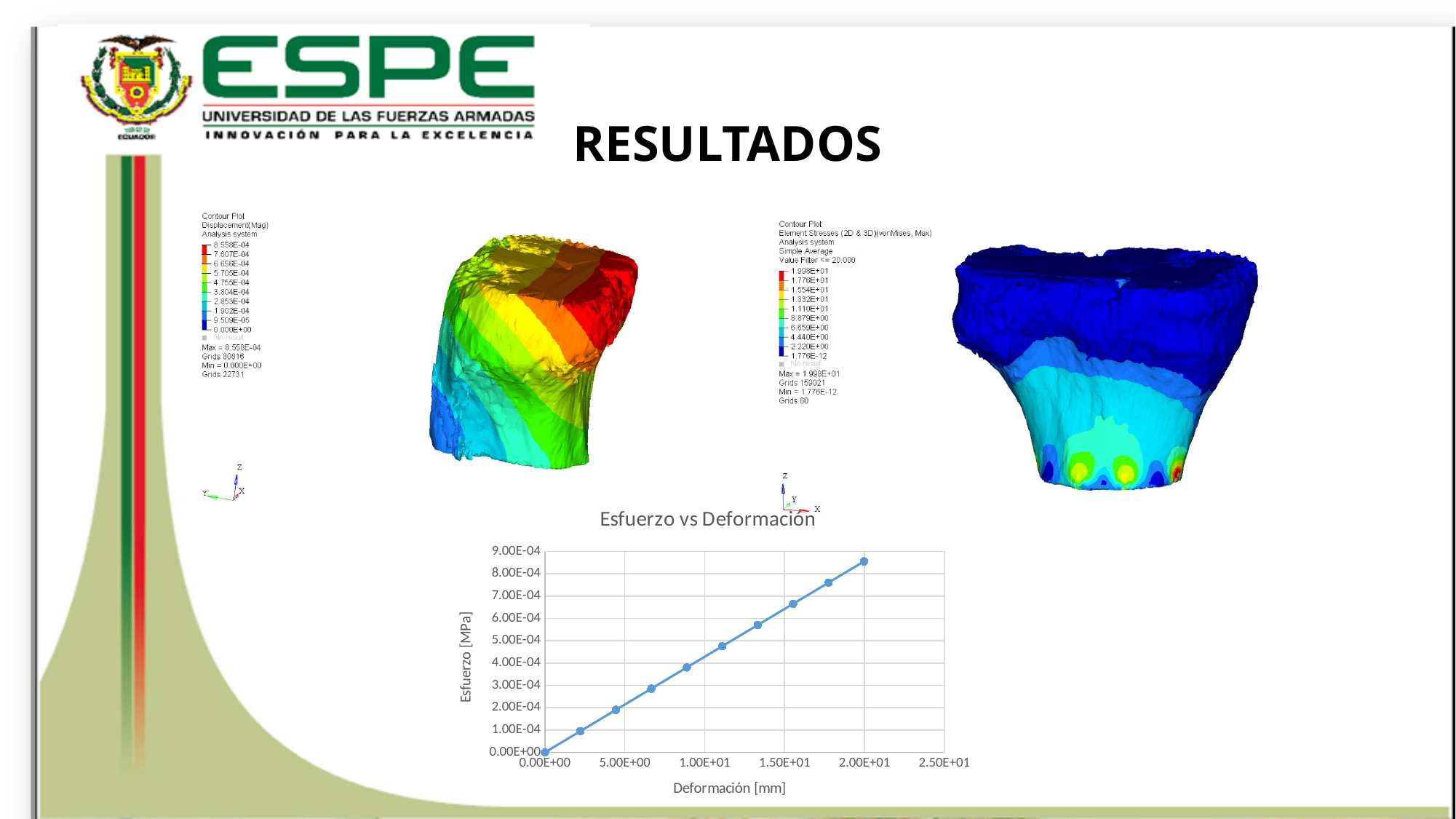
What is the label of the x axis in the 'Esfuerzo vs Deformación' chart? Deformación [mm] How many data points are plotted in the 'Esfuerzo vs Deformación' chart? 10 In the 'Esfuerzo vs Deformación' chart, which point has the highest Esfuerzo value, the one at the largest Deformación or the one at the smallest Deformación? the one at the largest Deformación What kind of chart is 'Esfuerzo vs Deformación'? line chart What is the label of the y axis in the 'Esfuerzo vs Deformación' chart? Esfuerzo [MPa] In the 'Esfuerzo vs Deformación' chart, is the highest plotted Esfuerzo value greater or less than 8.00E-04? greater In the 'Esfuerzo vs Deformación' chart, do the values rise or fall as Deformación increases? rise In the 'Esfuerzo vs Deformación' chart, is the Esfuerzo value at the point near Deformación 1.50E+01 greater or less than 5.00E-04? greater In the 'Esfuerzo vs Deformación' chart, is the Esfuerzo value at the point near Deformación 1.00E+01 greater or less than 5.00E-04? less In the 'Esfuerzo vs Deformación' chart, what is the Esfuerzo value at Deformación 0.00E+00? 0.00E+00